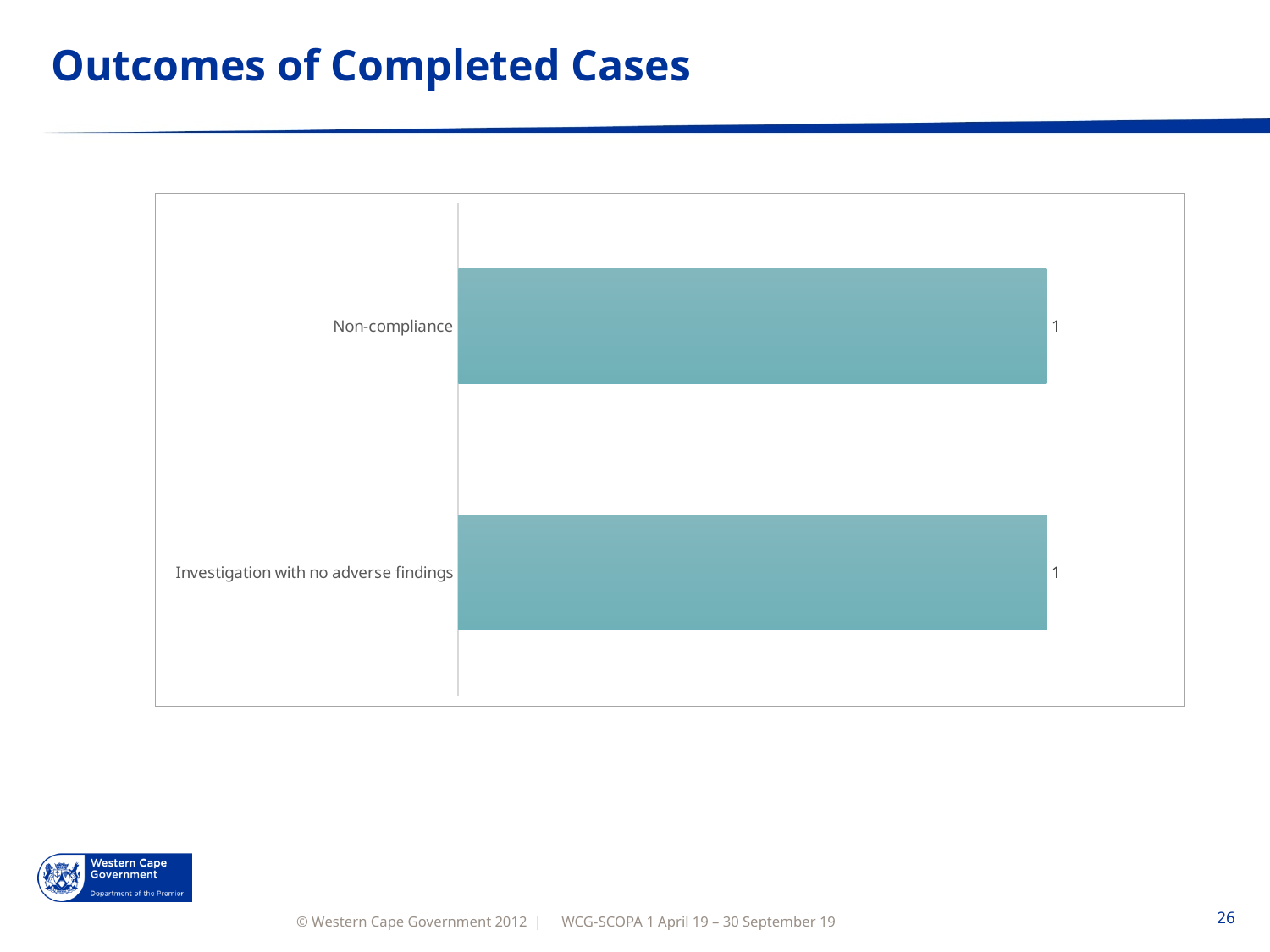
What kind of chart is shown on the slide? Bar chart What is the difference between the values for Non-compliance and Investigation with no adverse findings? 0 What is the value for Non-compliance? 1 Which category is listed at the top of the chart? Non-compliance What is the total of the values for Non-compliance and Investigation with no adverse findings? 2 How many categories are shown in the chart? 2 What is the value for Investigation with no adverse findings? 1 What is the title of the slide containing the chart? Outcomes of Completed Cases Are the bars in the chart horizontal or vertical? Horizontal